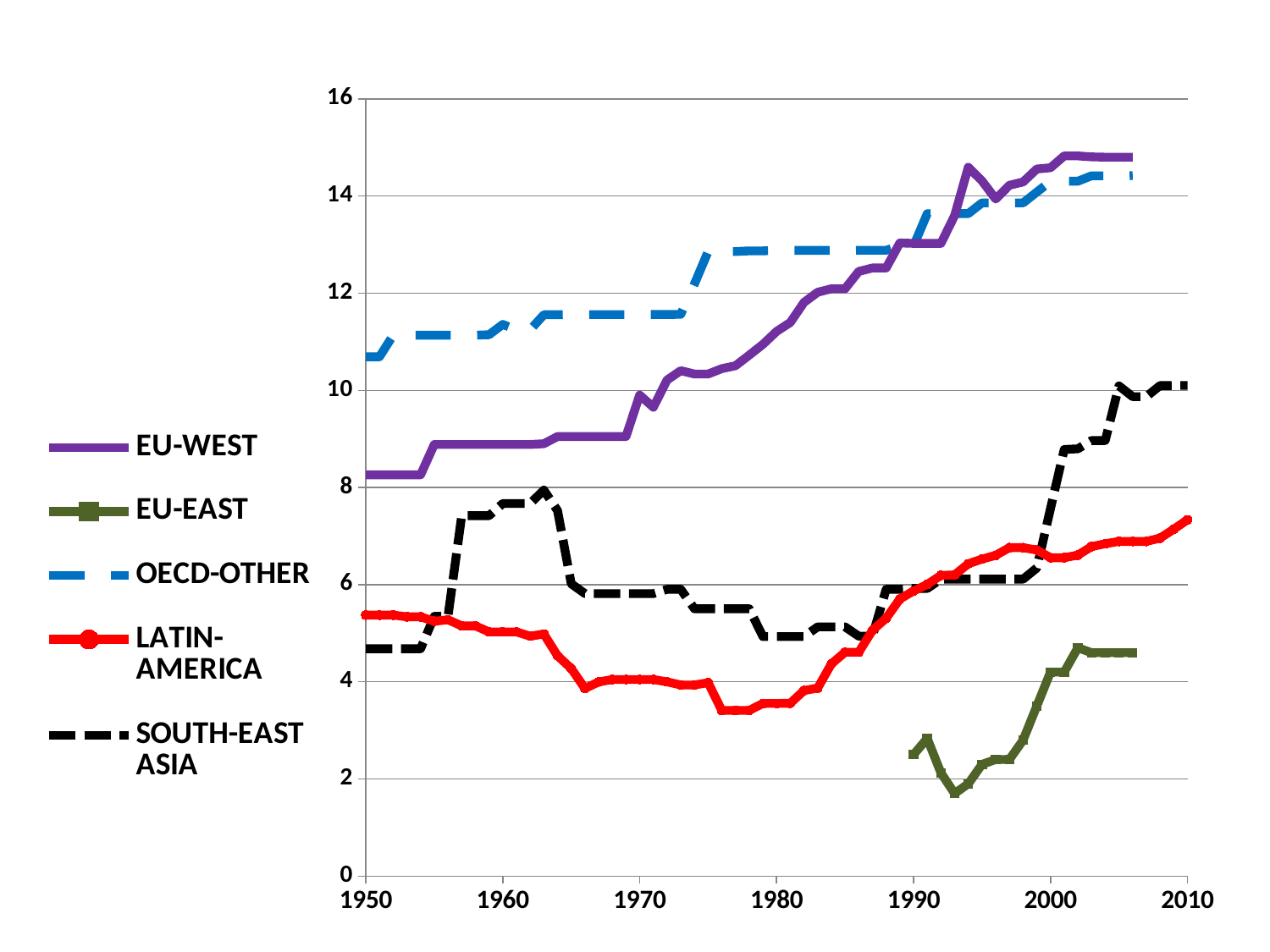
How many series does the legend list? 5 Which series is drawn as a black dashed line? SOUTH-EAST ASIA In 1970, which is larger: OECD-OTHER or EU-WEST? OECD-OTHER Is the value for EU-WEST in 1950 greater or less than 10? less In 2010, which is larger: SOUTH-EAST ASIA or LATIN-AMERICA? SOUTH-EAST ASIA Is the value for OECD-OTHER in 1950 greater or less than 10? greater Which series has the lowest value in 2000? EU-EAST Is the value for SOUTH-EAST ASIA in 2010 greater or less than 8? greater Which series only begins around 1990 rather than in 1950? EU-EAST Does the EU-WEST line rise or fall from 1950 to 2010? rises What kind of chart is shown on the slide? line chart